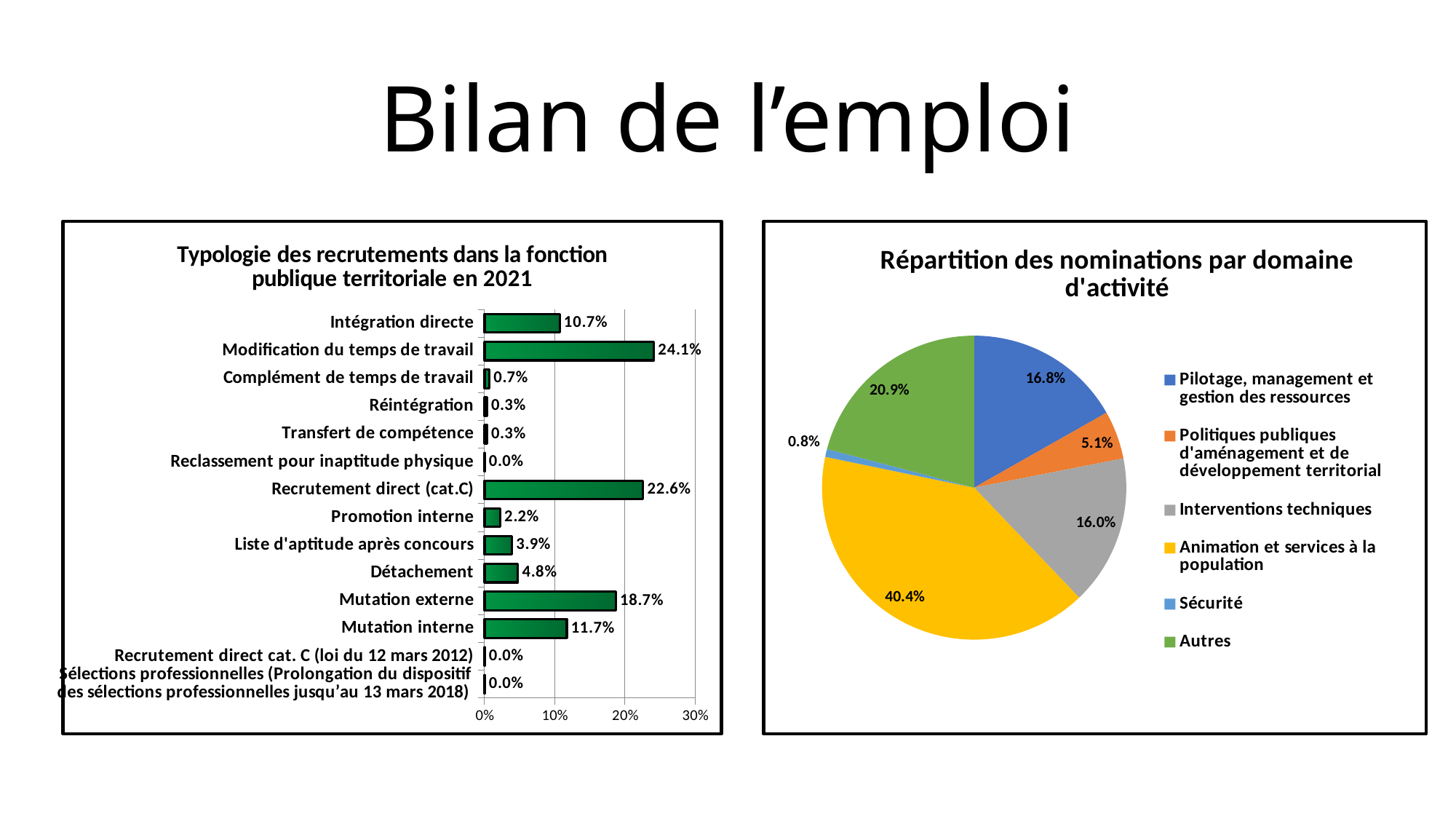
In the pie chart 'Répartition des nominations par domaine d'activité', what is the share for Animation et services à la population? 40.4% What kind of chart is 'Typologie des recrutements dans la fonction publique territoriale en 2021'? Bar chart In the chart 'Typologie des recrutements dans la fonction publique territoriale en 2021', what is the value for Modification du temps de travail? 24.1% In the pie chart 'Répartition des nominations par domaine d'activité', which domain has the smallest share? Sécurité In the chart 'Typologie des recrutements dans la fonction publique territoriale en 2021', what is the value for Mutation externe? 18.7% In the chart 'Typologie des recrutements dans la fonction publique territoriale en 2021', what is the difference between Recrutement direct (cat.C) and Mutation interne? 10.9% In the chart 'Typologie des recrutements dans la fonction publique territoriale en 2021', which is larger: Détachement or Liste d'aptitude après concours? Détachement In the chart 'Typologie des recrutements dans la fonction publique territoriale en 2021', which category has the highest value? Modification du temps de travail In the pie chart 'Répartition des nominations par domaine d'activité', what colour is the Autres slice? Green How many categories are shown in the chart 'Typologie des recrutements dans la fonction publique territoriale en 2021'? 14 How many entries does the legend of the pie chart 'Répartition des nominations par domaine d'activité' list? 6 In the pie chart 'Répartition des nominations par domaine d'activité', what is the value for Interventions techniques? 16.0%